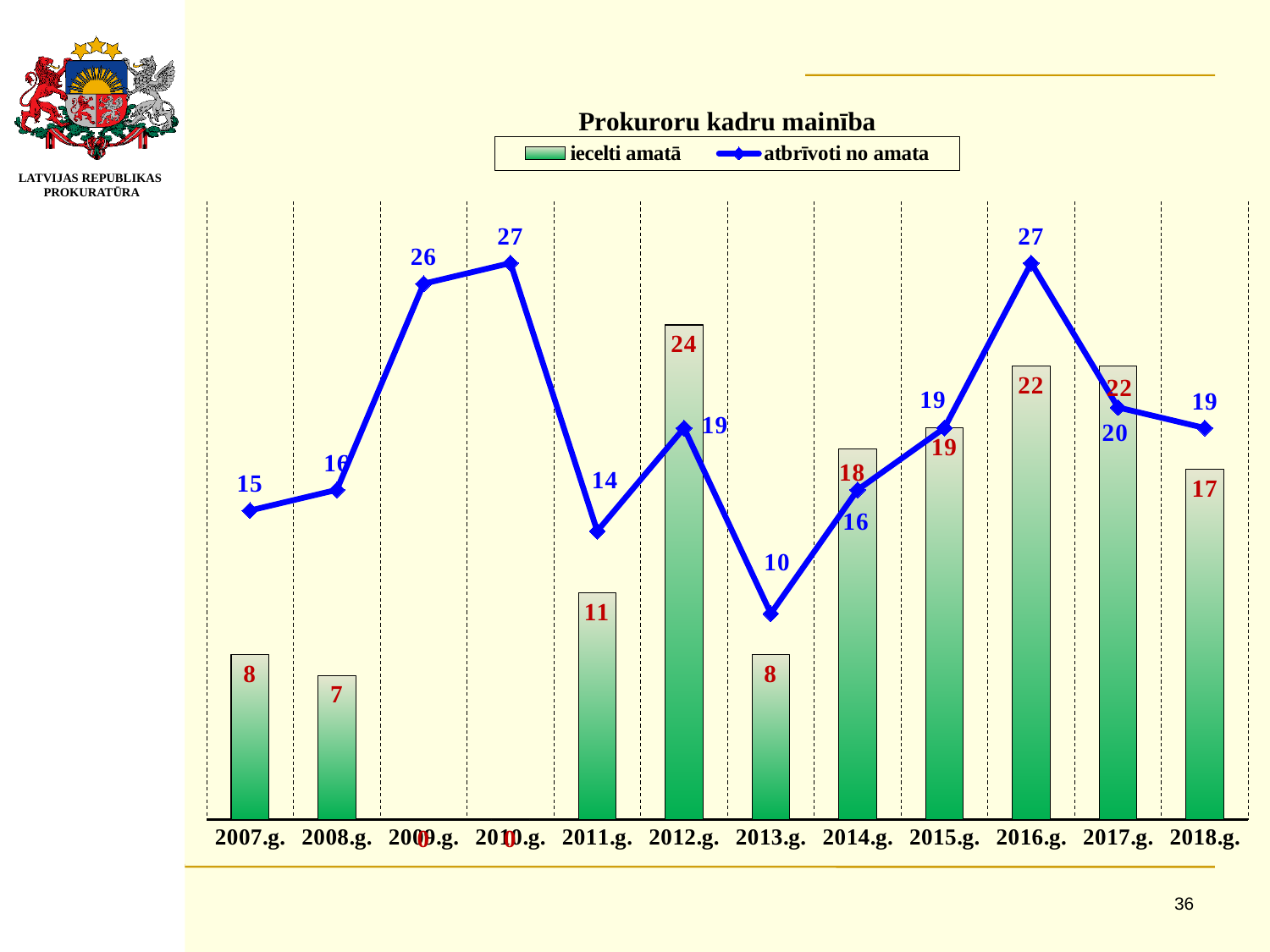
Which year has the lowest value for 'atbrīvoti no amata'? 2013.g. Does the 'atbrīvoti no amata' line rise or fall from 2016.g. to 2018.g.? Fall What kind of chart is this? Combined bar and line chart How many years are shown on the x axis? 12 What is the title of the chart? Prokuroru kadru mainība What is the difference between 'iecelti amatā' and 'atbrīvoti no amata' in 2012.g.? 5 What is the value of 'iecelti amatā' for 2012.g.? 24 How many series does the legend list? 2 What is the value of 'iecelti amatā' for 2018.g.? 17 Which year has the highest value for 'iecelti amatā'? 2012.g. What is the value of 'atbrīvoti no amata' for 2013.g.? 10 Which is larger in 2011.g., 'iecelti amatā' or 'atbrīvoti no amata'? atbrīvoti no amata